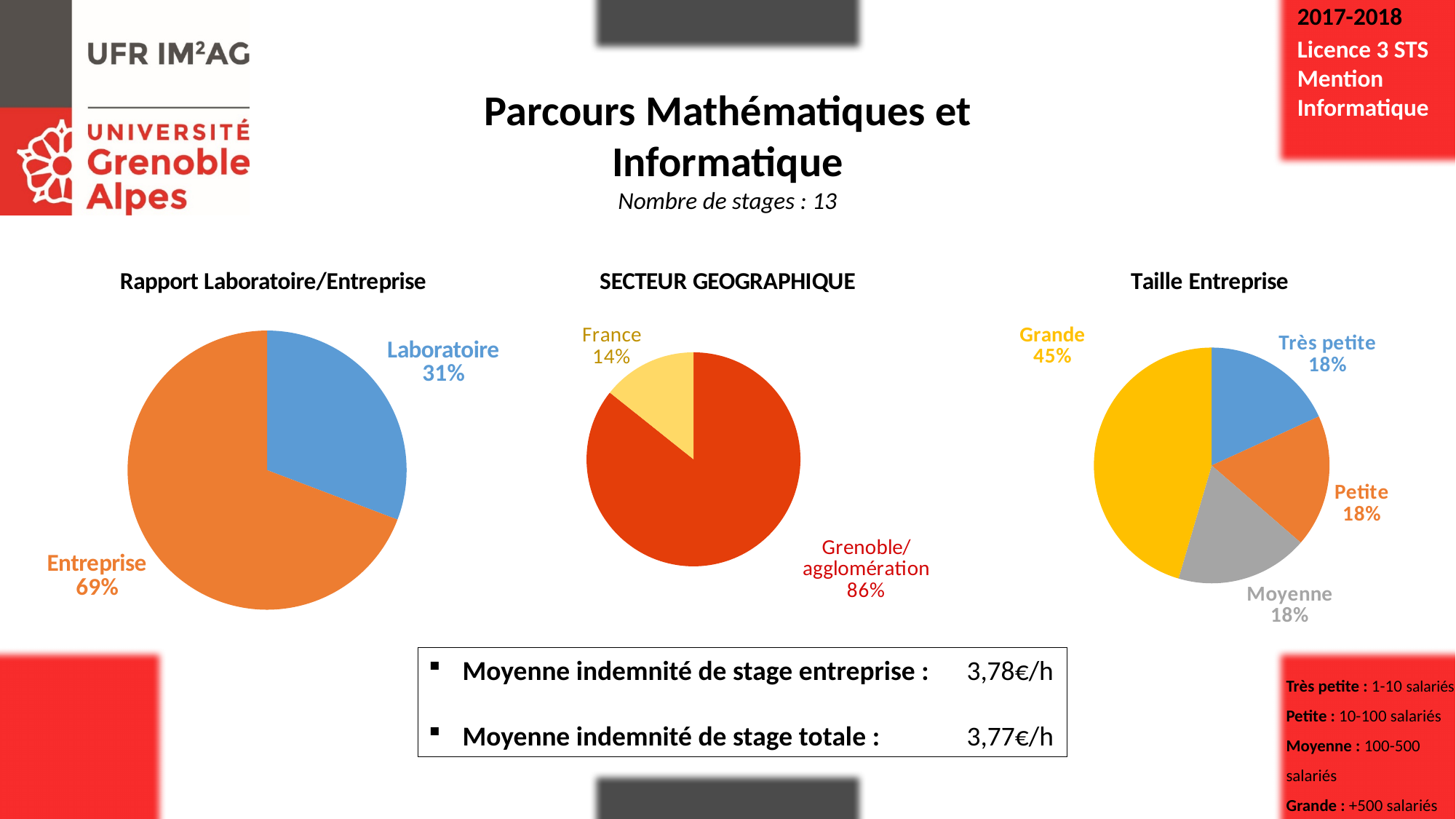
In the 'SECTEUR GEOGRAPHIQUE' chart, which slice is the smallest? France How many slices does the 'Taille Entreprise' chart have? 4 What kind of chart is the 'Taille Entreprise' chart? Pie chart In the 'Rapport Laboratoire/Entreprise' chart, which slice is the largest? Entreprise In the 'Rapport Laboratoire/Entreprise' chart, what share does Laboratoire have? 31% In the 'SECTEUR GEOGRAPHIQUE' chart, what share does Grenoble/agglomération have? 86% In the 'SECTEUR GEOGRAPHIQUE' chart, what share does France have? 14% In the 'Taille Entreprise' chart, which slice is the largest? Grande In the 'Rapport Laboratoire/Entreprise' chart, what is the difference in percentage points between Entreprise and Laboratoire? 38 How many slices does the 'SECTEUR GEOGRAPHIQUE' chart have? 2